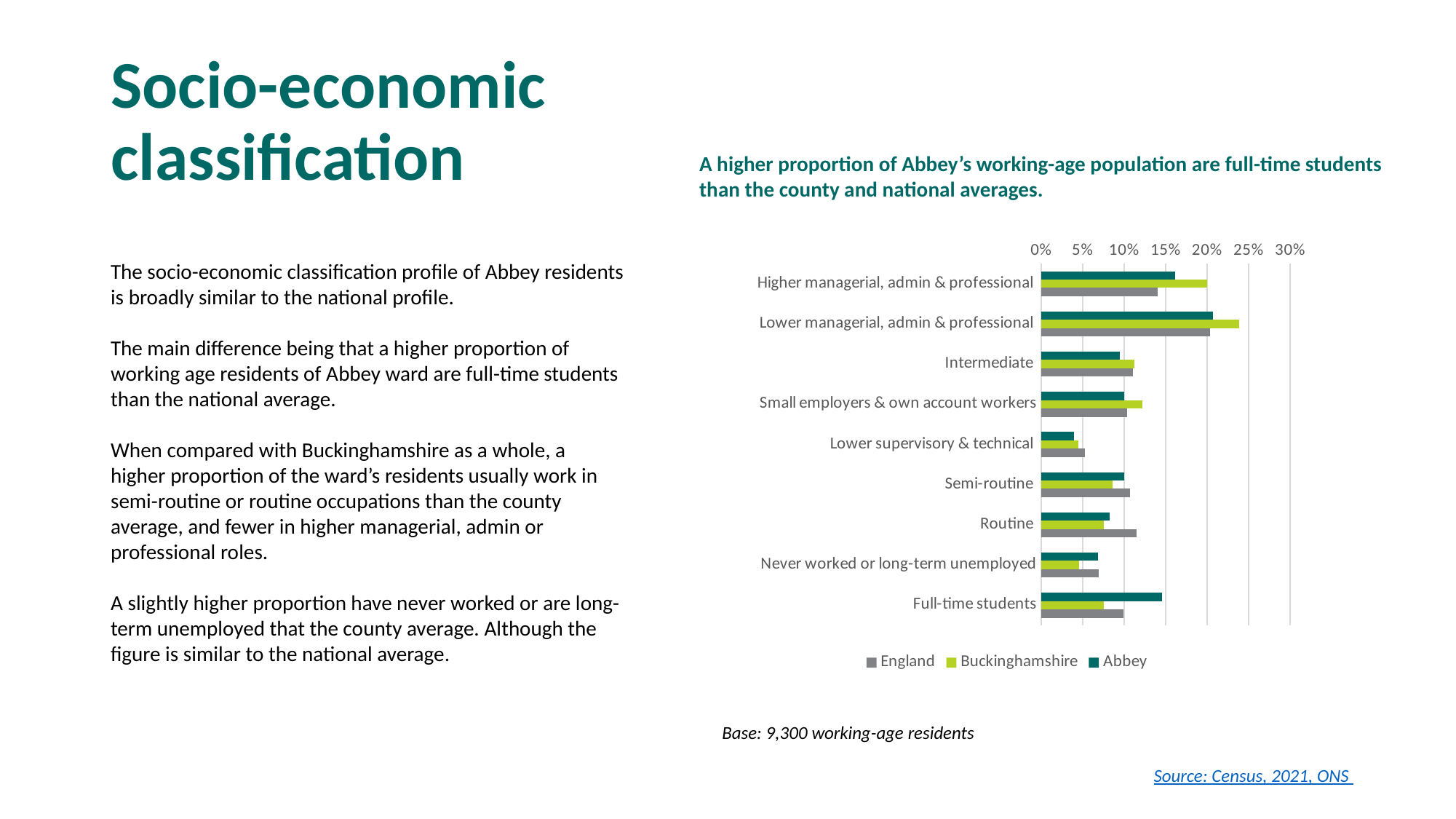
For Higher managerial, admin & professional, which is larger: the value for Buckinghamshire or the value for Abbey? Buckinghamshire Which category has the highest value for Buckinghamshire? Lower managerial, admin & professional For Full-time students, which is larger: the value for Abbey or the value for Buckinghamshire? Abbey Is the Abbey value for Full-time students greater or less than 10%? greater Is the Abbey value for Lower supervisory & technical greater or less than 5%? less What kind of chart is shown on the slide? Bar chart How many series does the chart's legend list? 3 How many socio-economic categories are plotted on the chart? 9 Is the Buckinghamshire value for Lower managerial, admin & professional greater or less than 20%? greater Which category has the highest value for Abbey? Lower managerial, admin & professional Which category has the lowest value for Abbey? Lower supervisory & technical For Routine, which is larger: the value for England or the value for Abbey? England